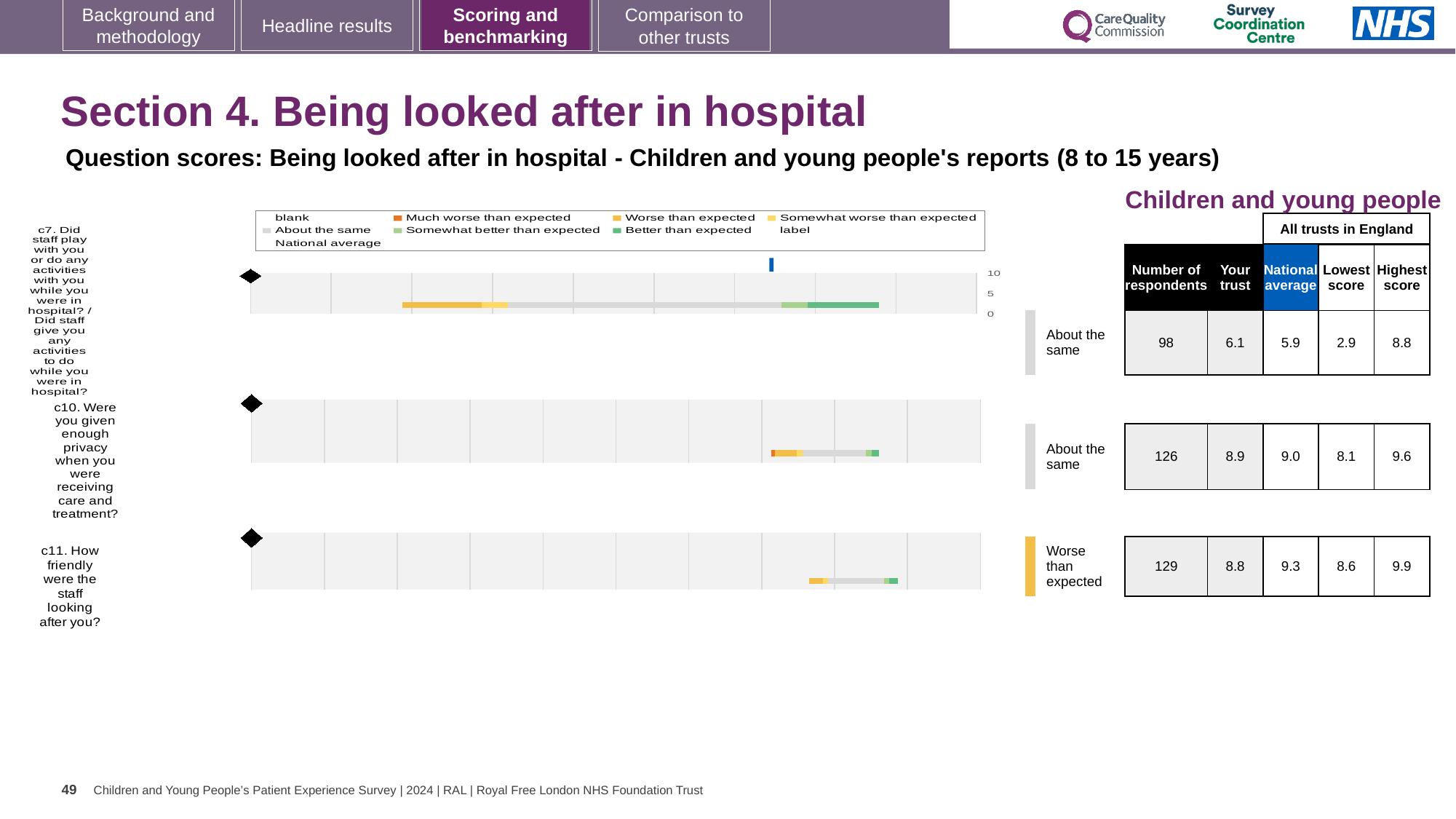
What kind of chart is used to show the question scores on this slide? bar chart How many survey questions (c7, c10, c11) have a chart on this slide? 3 Is the 'Your trust' score for question c7 greater or less than 5? greater For question c7, what is the difference between the highest score (8.8) and the lowest score (2.9) across all trusts in England? 5.9 For question c11 (how friendly were the staff), what is the national average score? 9.3 What benchmark category is shown for question c11 (how friendly were the staff)? Worse than expected Which question has the lowest number of respondents on this slide? c7 How many respondents answered question c7 (did staff play with you or do any activities with you)? 98 For question c10 (privacy when receiving care and treatment), what is the 'Your trust' score? 8.9 What benchmark category is shown for question c7 (did staff play with you or do any activities with you)? About the same For question c11, which is larger: the 'Your trust' score or the national average? National average Which question has the highest 'Your trust' score on this slide? c10